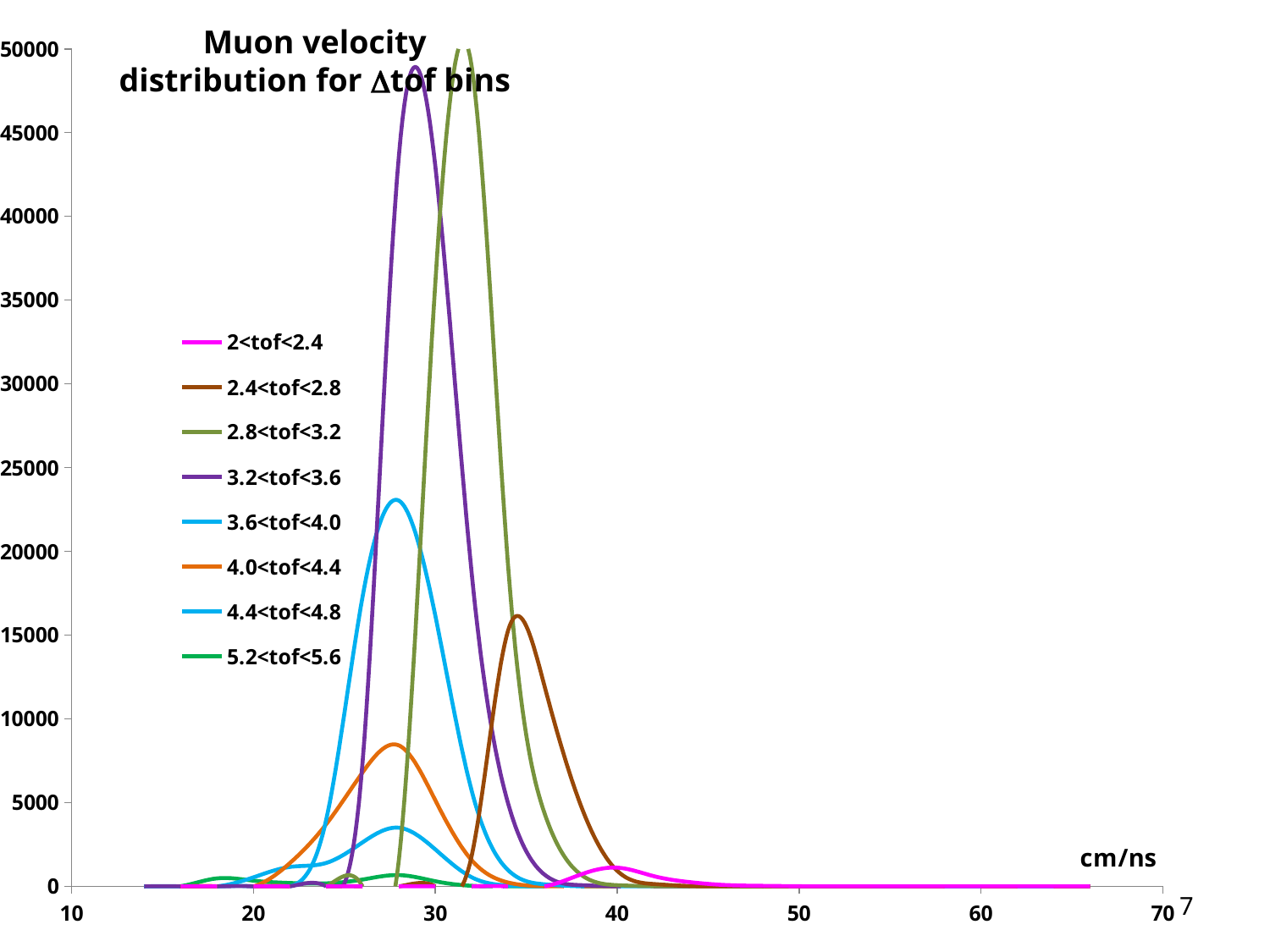
Is the peak value of the 4.0<tof<4.4 series greater or less than 10000? less Is the peak value of the 2<tof<2.4 series greater or less than 5000? less How many series does the legend list? 8 Which series peaks at a higher velocity on the x axis, 2.4<tof<2.8 or 3.2<tof<3.6? 2.4<tof<2.8 Which series has the higher peak, 3.2<tof<3.6 or 2.4<tof<2.8? 3.2<tof<3.6 What is the title of the chart? Muon velocity distribution for Δtof bins Is the peak value of the 5.2<tof<5.6 series greater or less than 5000? less What unit label is shown on the x axis? cm/ns Which series has the higher peak, 2.4<tof<2.8 or 4.0<tof<4.4? 2.4<tof<2.8 What kind of chart is shown on the slide? line chart